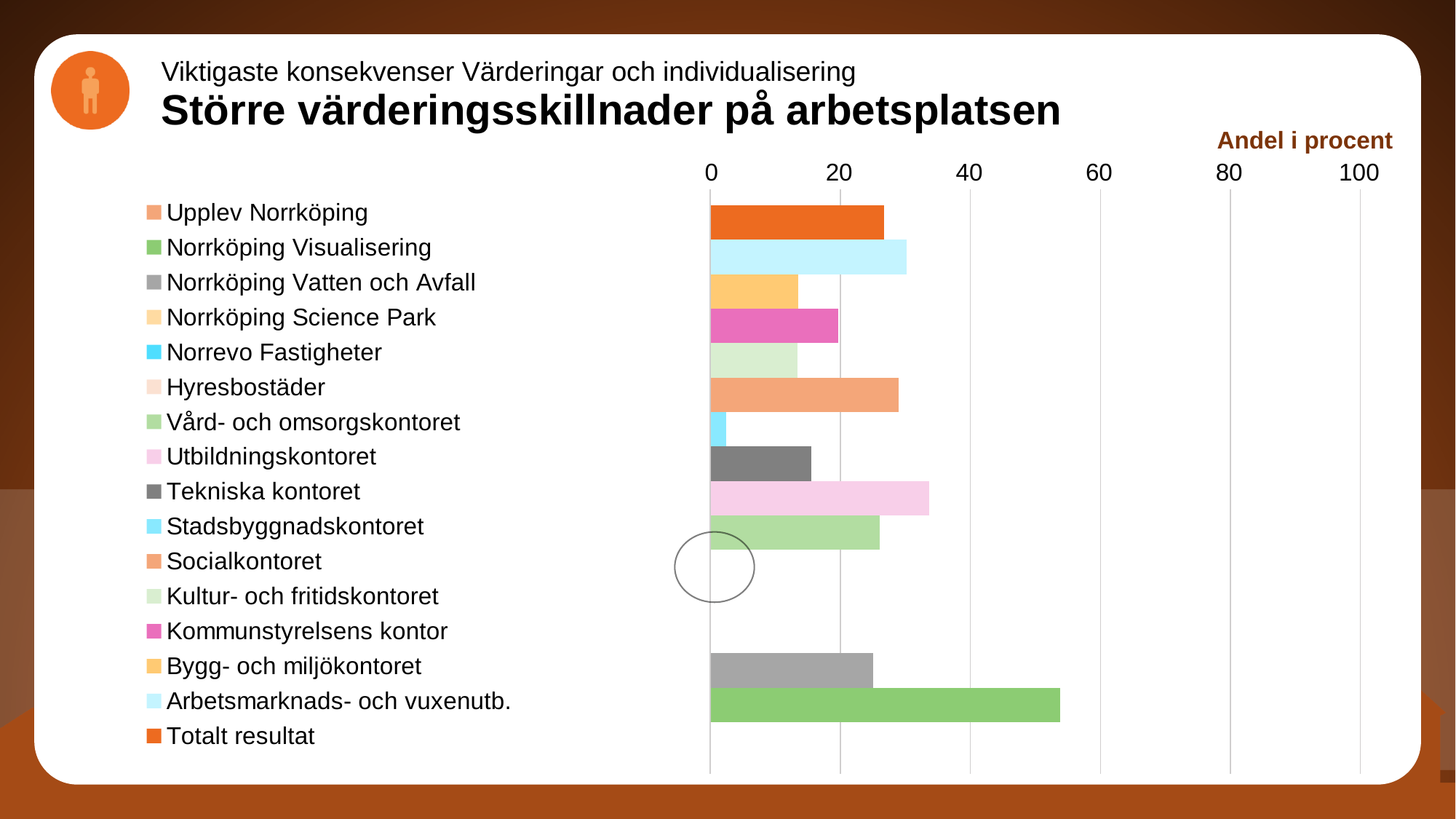
Which category has the longest bar in the chart? Norrköping Visualisering Is the value for Tekniska kontoret greater or less than 20? less What is the highest tick value shown on the horizontal axis? 100 Which is larger, the value for Norrköping Visualisering or the value for Utbildningskontoret? Norrköping Visualisering What kind of chart is shown on the slide? bar chart Is the value for Stadsbyggnadskontoret greater or less than 20? less Is the value for Utbildningskontoret greater or less than 40? less What label is shown above the horizontal axis of the chart? Andel i procent Which is larger, the value for Socialkontoret or the value for Stadsbyggnadskontoret? Socialkontoret How many entries does the chart legend list? 16